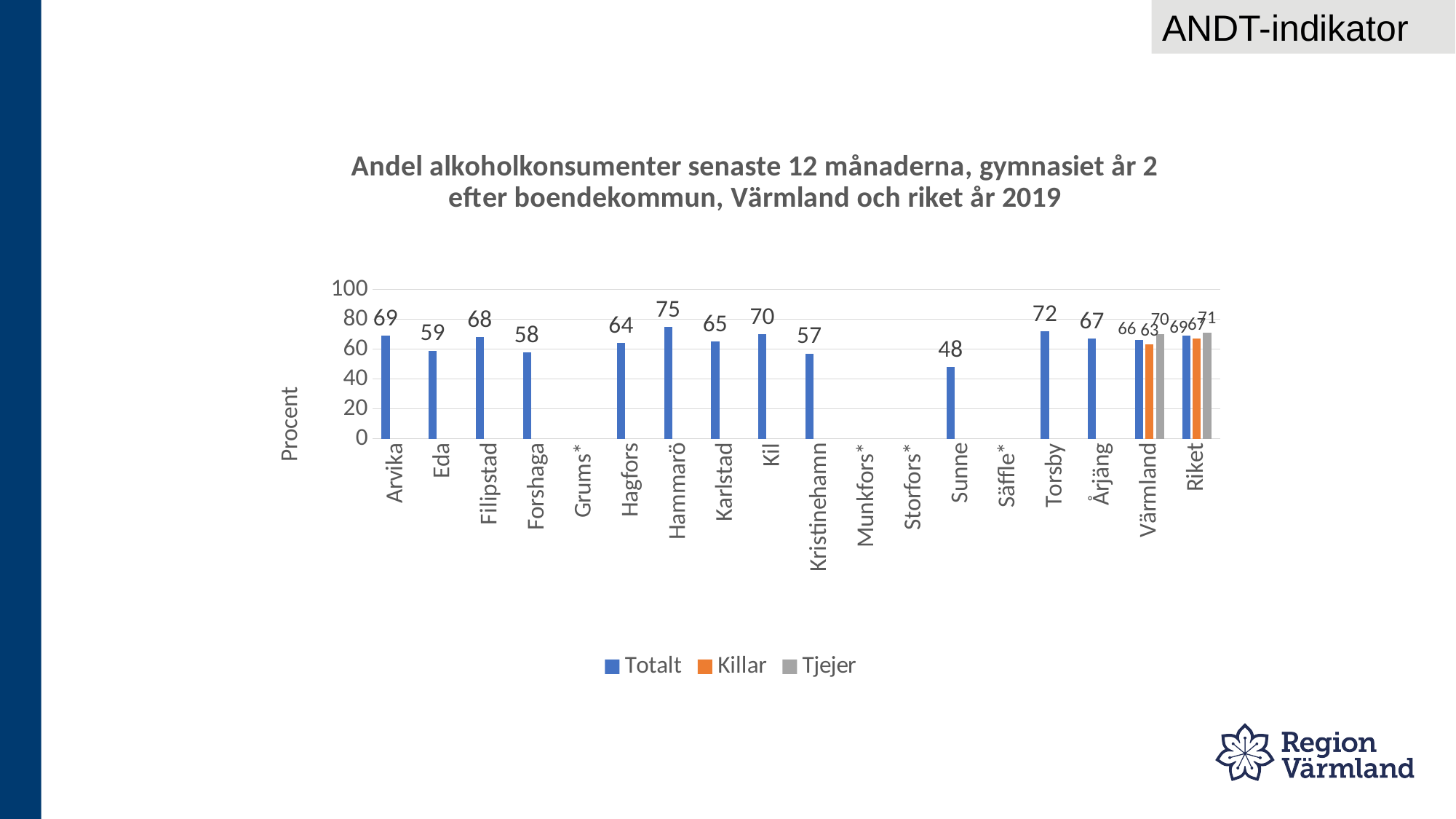
What is the label of the y axis? Procent Which has a higher Totalt value, Kil or Karlstad? Kil What is the Killar value for Riket? 67 How many series does the legend list? 3 What is the Totalt value for Sunne? 48 How many categories are shown on the x axis? 18 Which municipality has the highest Totalt value? Hammarö What is the Tjejer value for Värmland? 70 What is the Totalt value for Hammarö? 75 Which municipality has the lowest plotted Totalt value? Sunne What is the difference between the Totalt values for Torsby and Eda? 13 What kind of chart is shown on the slide? Bar chart